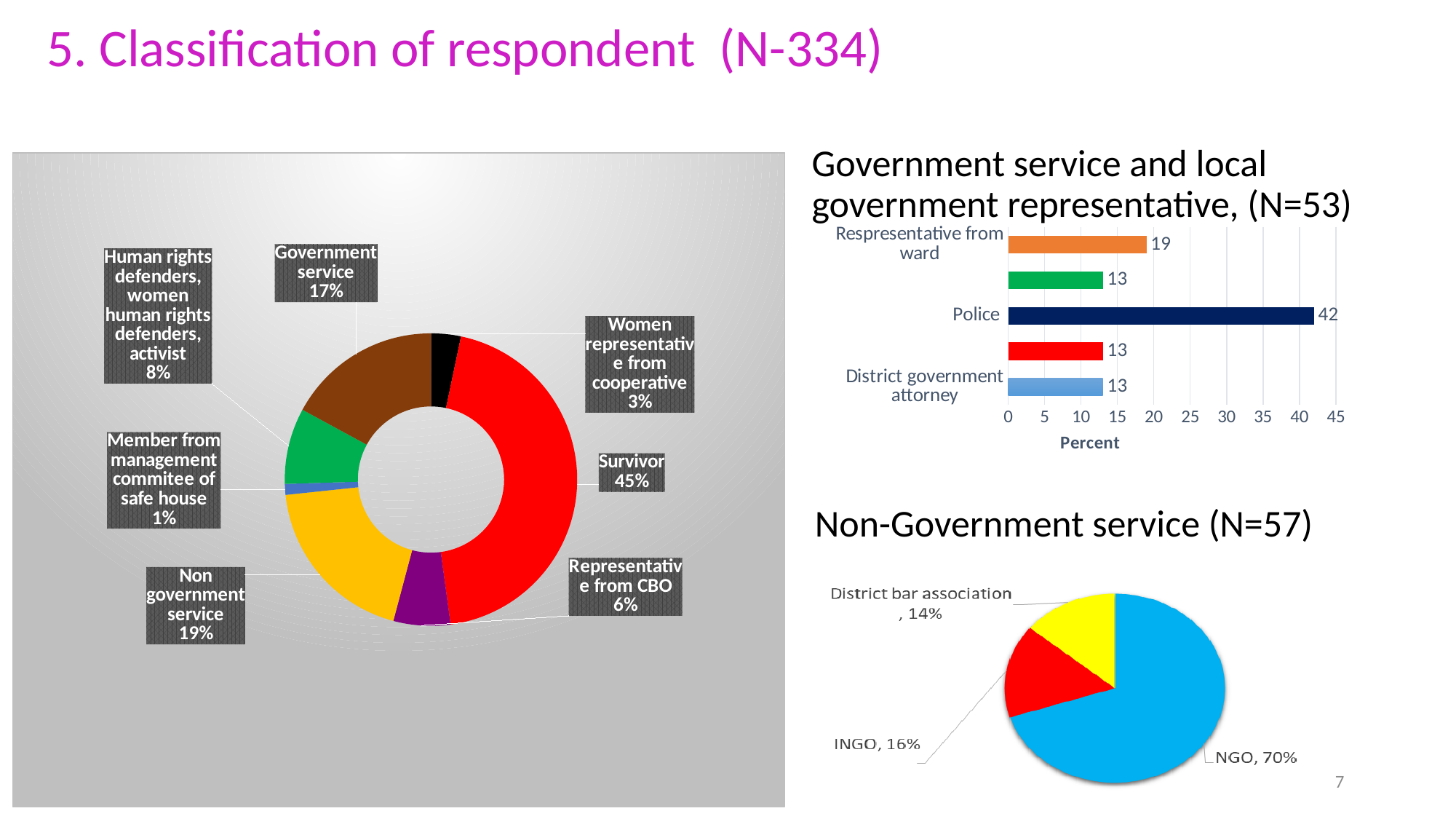
In the left doughnut chart, what is the difference between the Government service share and the Human rights defenders share? 9% In the 'Non-Government service' pie chart, which is larger, INGO or District bar association? INGO In the 'Government service and local government representative' bar chart, what is the value for Police? 42 In the 'Government service and local government representative' bar chart, what is the value for Respresentative from ward? 19 In the 'Non-Government service' pie chart, what share is NGO? 70% What kind of chart is the 'Government service and local government representative' chart? Bar chart In the 'Government service and local government representative' bar chart, which category has the highest value? Police In the left doughnut chart, how many categories are shown? 7 In the left doughnut chart, which category has the smallest share? Member from management commitee of safe house In the left doughnut chart, what share of respondents are Survivors? 45% In the 'Government service and local government representative' bar chart, how many bars are plotted? 5 In the left doughnut chart, what percentage of respondents are from Non government service? 19%